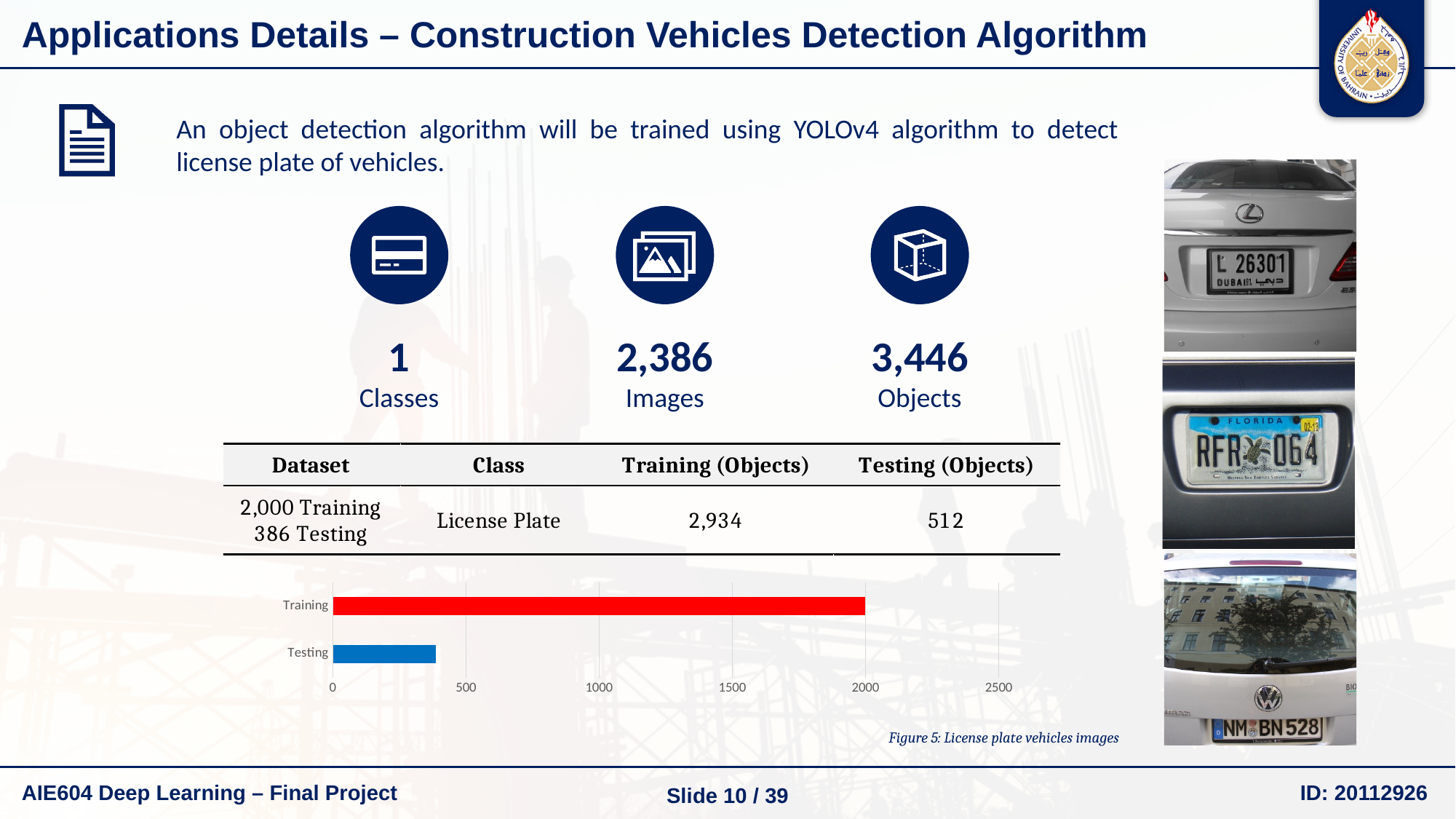
How many categories are plotted in the bar chart? 2 Is the value for Training in the bar chart greater or less than 1500? greater Which bar is longer in the chart, Training or Testing? Training Which category has the shortest bar in the chart? Testing Is the value for Testing in the bar chart greater or less than 500? less What kind of chart is shown at the bottom of the slide? bar chart What colour is the Testing bar in the chart? blue What colour is the Training bar in the chart? red Which category has the longest bar in the chart? Training In the bar chart, what value does the Training bar reach on the axis? 2000 Is the value for Testing in the bar chart greater or less than 1000? less